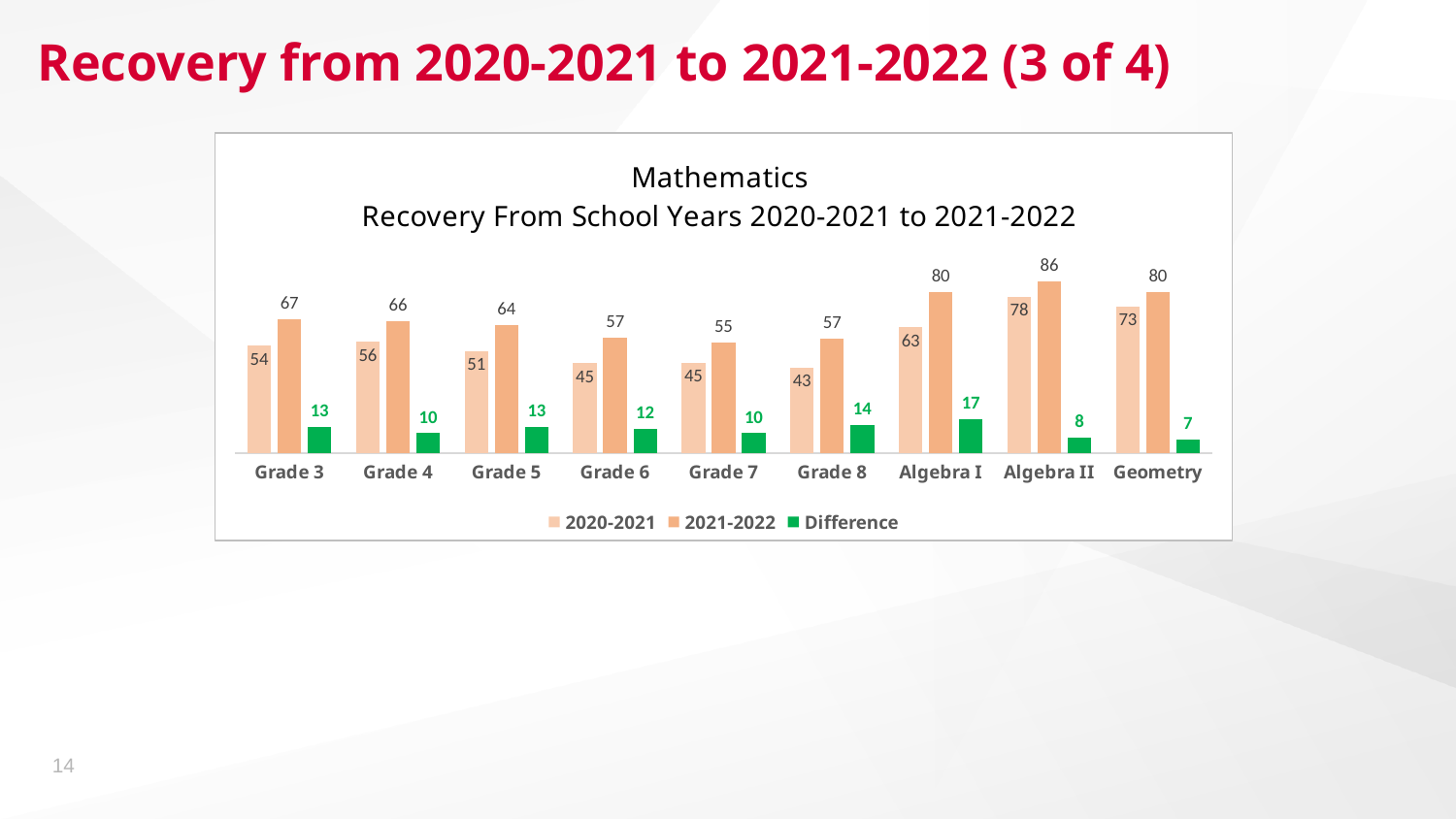
How many categories are shown on the x axis? 9 What is the 2021-2022 value for Grade 5? 64 What is the 2020-2021 value for Grade 8? 43 Which category has the lowest 2020-2021 value? Grade 8 What kind of chart is shown? Bar chart Which category has the highest 2021-2022 value? Algebra II Which is larger, the 2020-2021 value for Grade 4 or the 2020-2021 value for Grade 7? Grade 4 What is the difference between the 2021-2022 and 2020-2021 values for Grade 6? 12 What is the Difference value for Algebra I? 17 What is the title of the chart? Mathematics Recovery From School Years 2020-2021 to 2021-2022 Which category has the lowest Difference value? Geometry How many series does the legend list? 3